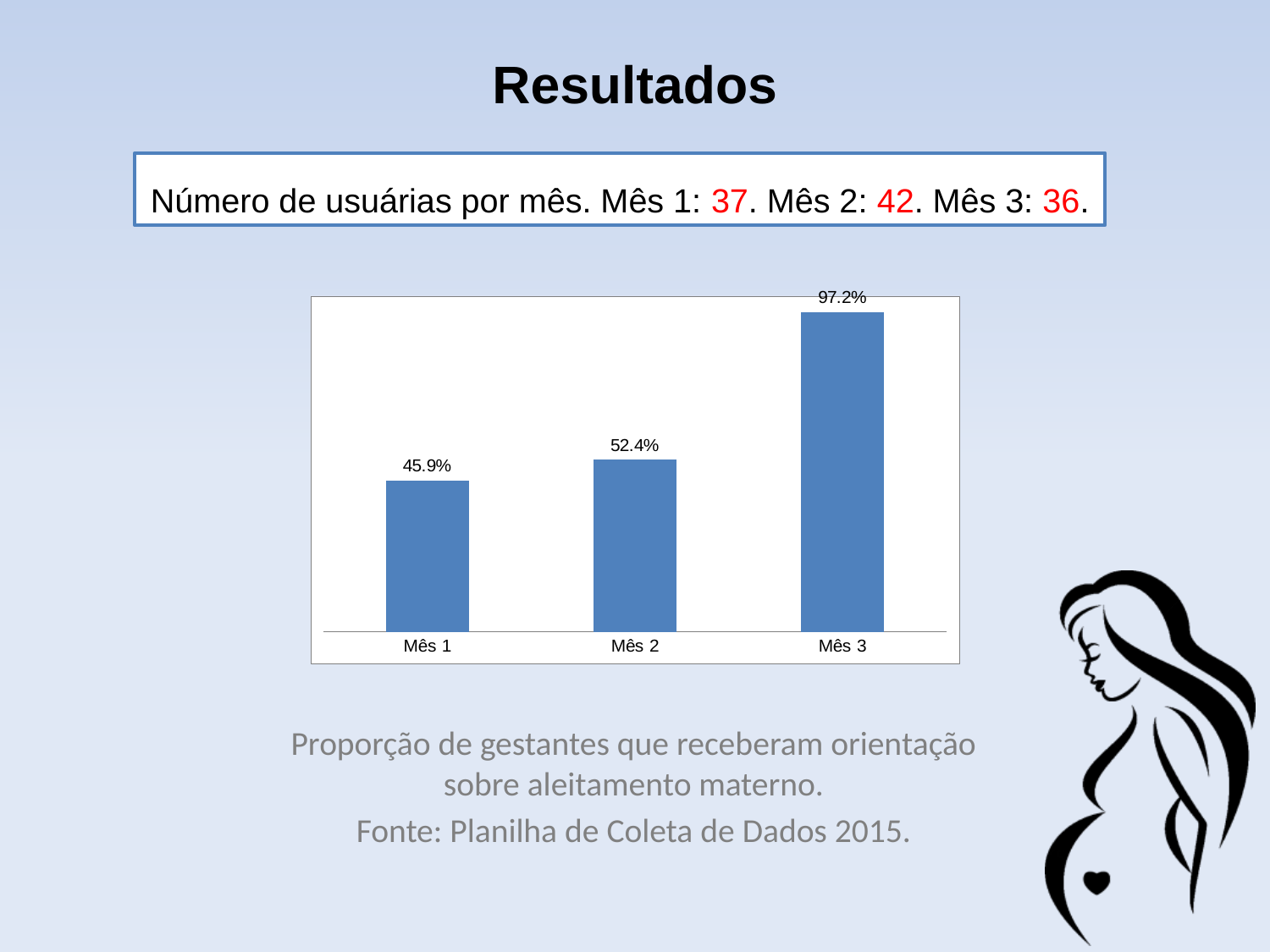
What is the difference between the values for Mês 3 and Mês 2? 44.8% What kind of chart is shown on the slide? Bar chart According to the caption below the chart, what does the chart show? Proporção de gestantes que receberam orientação sobre aleitamento materno Which month has the highest value? Mês 3 Do the values rise or fall from Mês 1 to Mês 3? Rise Which is larger, the value for Mês 1 or the value for Mês 2? Mês 2 What is the difference between the values for Mês 2 and Mês 1? 6.5% How many categories are shown on the x axis? 3 What is the value for Mês 2? 52.4% Which month has the lowest value? Mês 1 What is the value for Mês 1? 45.9% What is the value for Mês 3? 97.2%